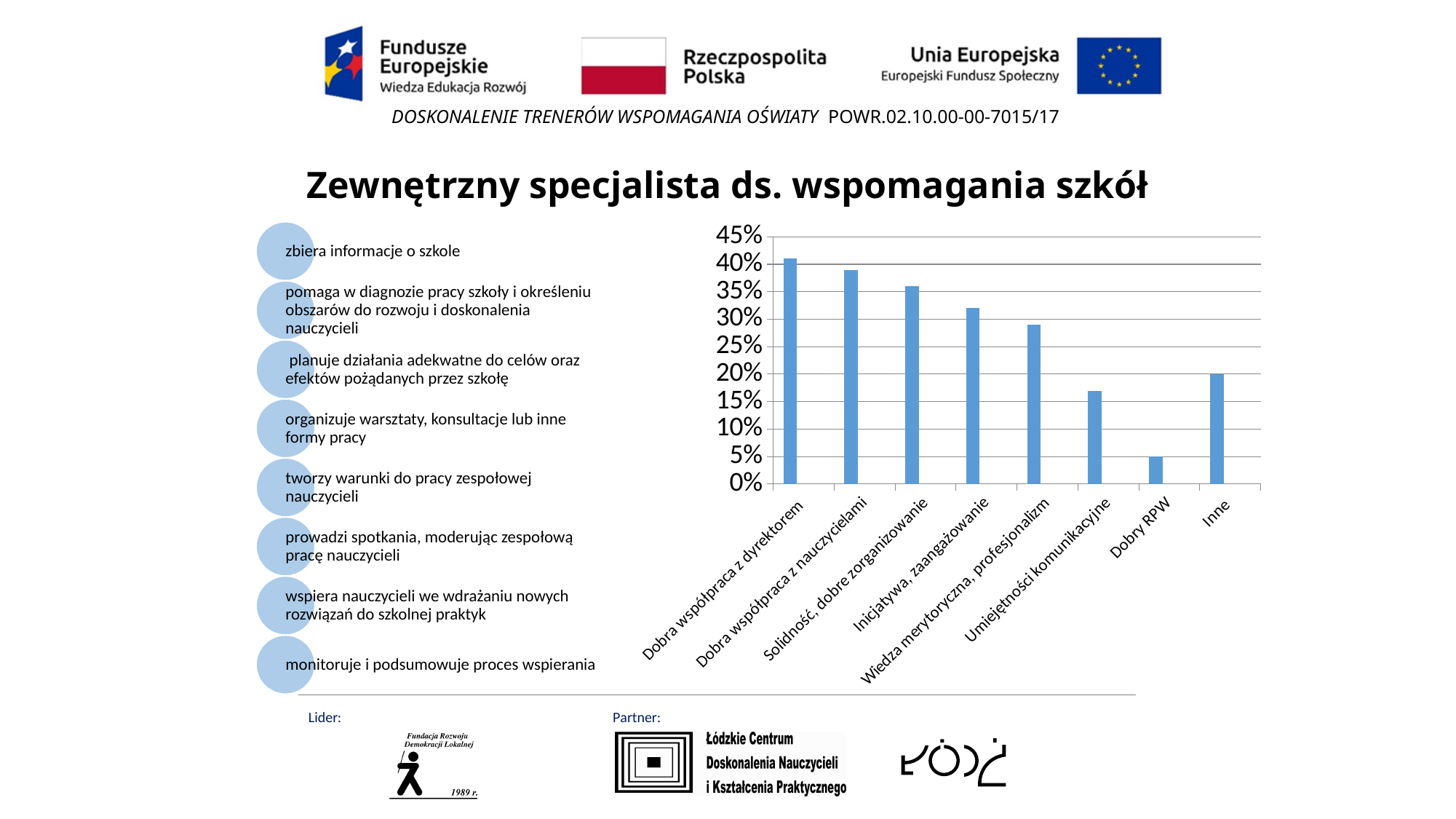
What kind of chart is shown on the slide? bar chart Is the value for Dobra współpraca z dyrektorem greater or less than 35%? greater Which is larger, the value for Inne or the value for Umiejętności komunikacyjne? Inne Which category has the highest value in the chart? Dobra współpraca z dyrektorem Is the value for Dobra współpraca z nauczycielami greater or less than 40%? less Which category has the lowest value in the chart? Dobry RPW How many categories are shown on the x axis of the chart? 8 What colour are the bars in the chart? blue Is the value for Wiedza merytoryczna, profesjonalizm greater or less than 30%? less What is the value for Dobry RPW? 5% What is the value for Inne? 20%